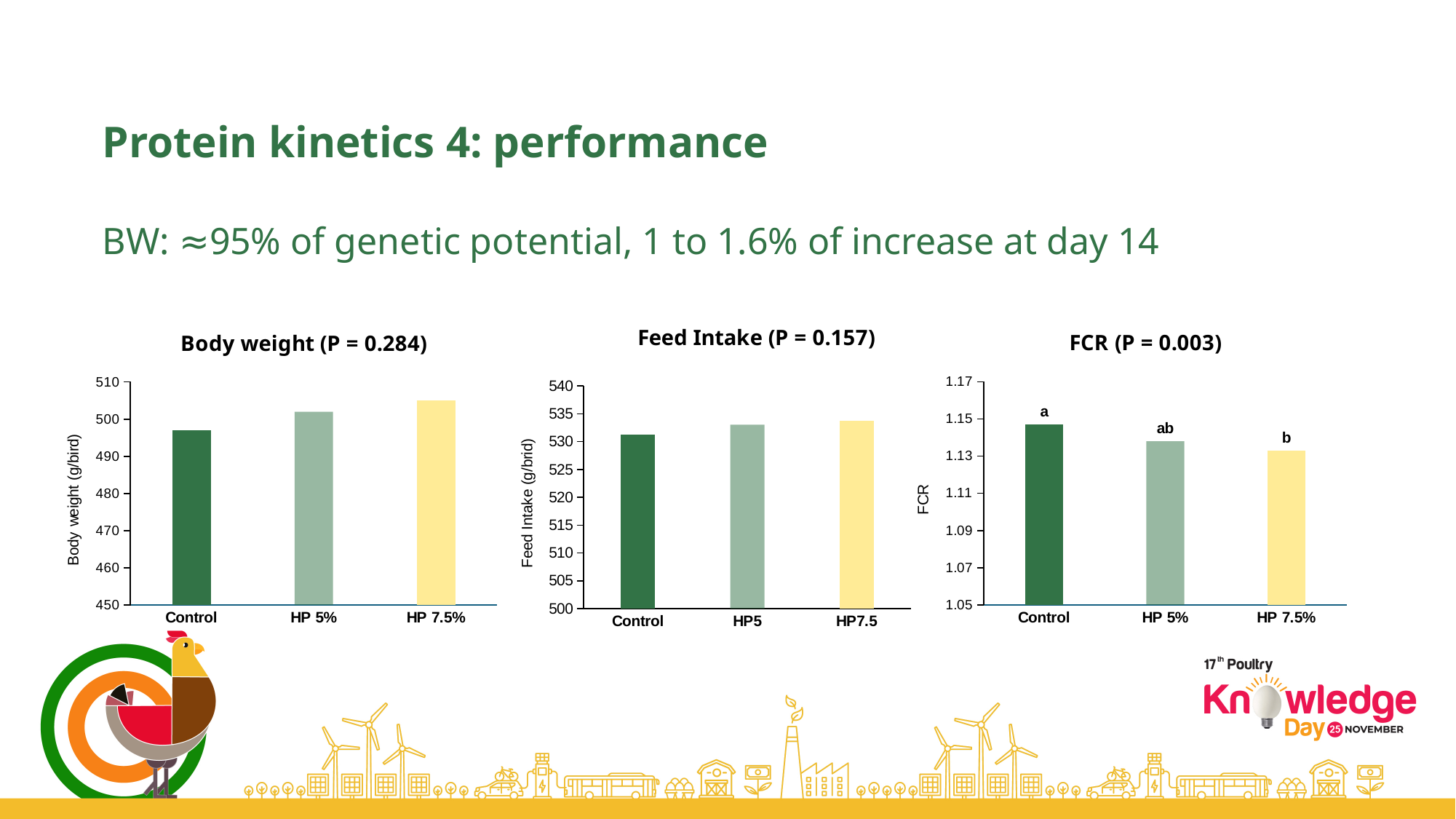
In the FCR (P = 0.003) chart, which category has the highest FCR? Control In the Feed Intake (P = 0.157) chart, which category has the lowest feed intake? Control In the FCR (P = 0.003) chart, do the values rise or fall from Control to HP 7.5%? fall In the Body weight (P = 0.284) chart, which category has the lowest body weight? Control In the FCR (P = 0.003) chart, which category has the lowest FCR? HP 7.5% What kind of chart is the Body weight (P = 0.284) chart? bar chart In the FCR (P = 0.003) chart, what letter is printed above the Control bar? a How many categories are shown on the Feed Intake (P = 0.157) chart? 3 In the Body weight (P = 0.284) chart, is the value for HP 7.5% greater or less than 500? greater In the Body weight (P = 0.284) chart, is the value for Control greater or less than 500? less In the Feed Intake (P = 0.157) chart, is the value for HP5 greater or less than 530? greater In the Body weight (P = 0.284) chart, which category has the highest body weight? HP 7.5%